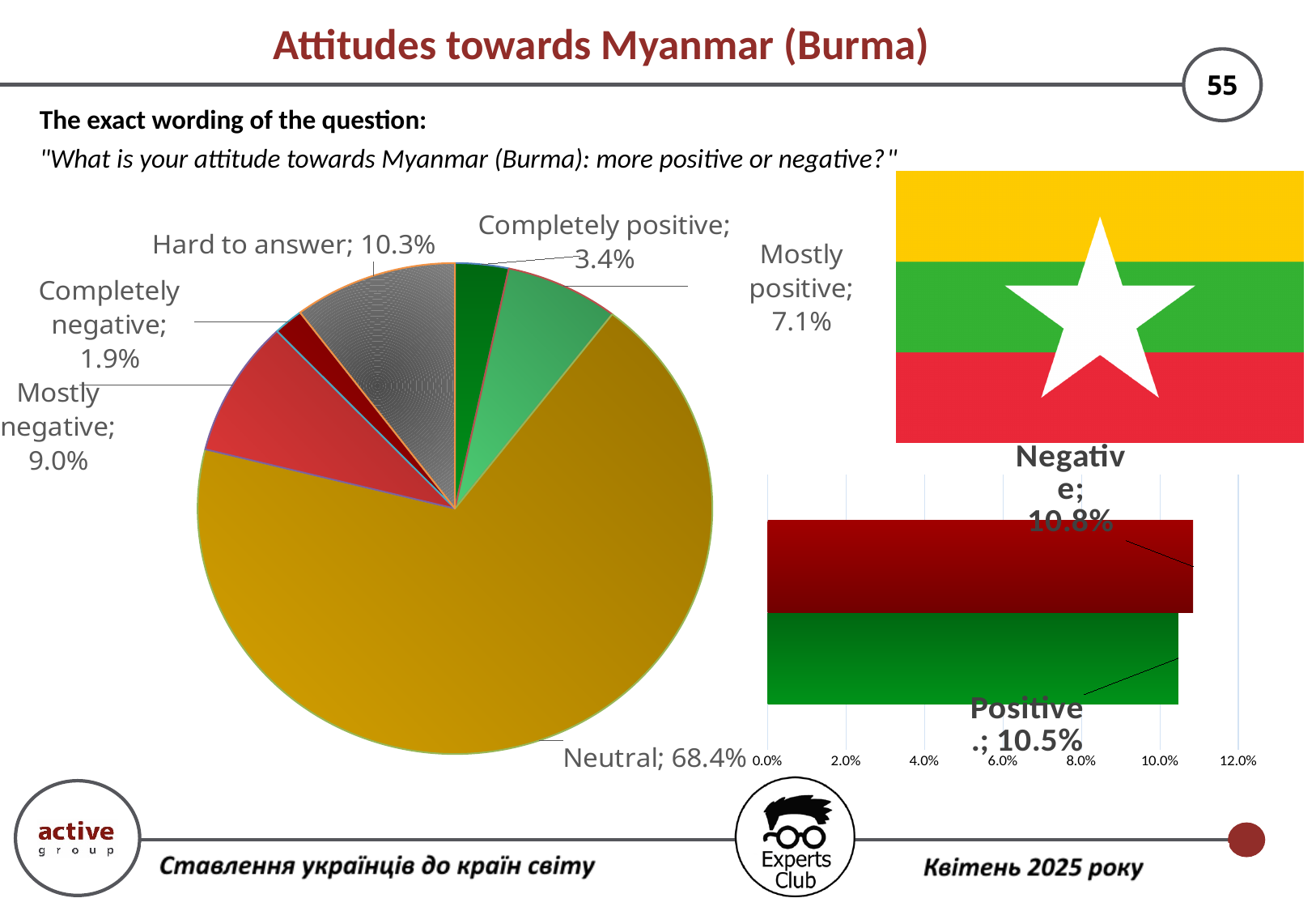
In the bar chart on the right, what is the value for "Negative"? 10.8% How many categories does the pie chart show? 6 In the bar chart on the right, what is the value for "Positive"? 10.5% In the pie chart, what share of respondents answered "Neutral"? 68.4% In the pie chart, which category has the smallest share? Completely negative In the pie chart, what is the value for "Completely positive"? 3.4% In the pie chart, which is larger: "Mostly negative" or "Mostly positive"? Mostly negative In the pie chart, what is the difference between "Mostly positive" and "Completely positive"? 3.7% In the pie chart, what is the value for "Hard to answer"? 10.3% In the pie chart, which category has the largest share? Neutral What type of chart is shown on the right side of the slide below the flag? Bar chart In the pie chart, what is the value for "Mostly negative"? 9.0%